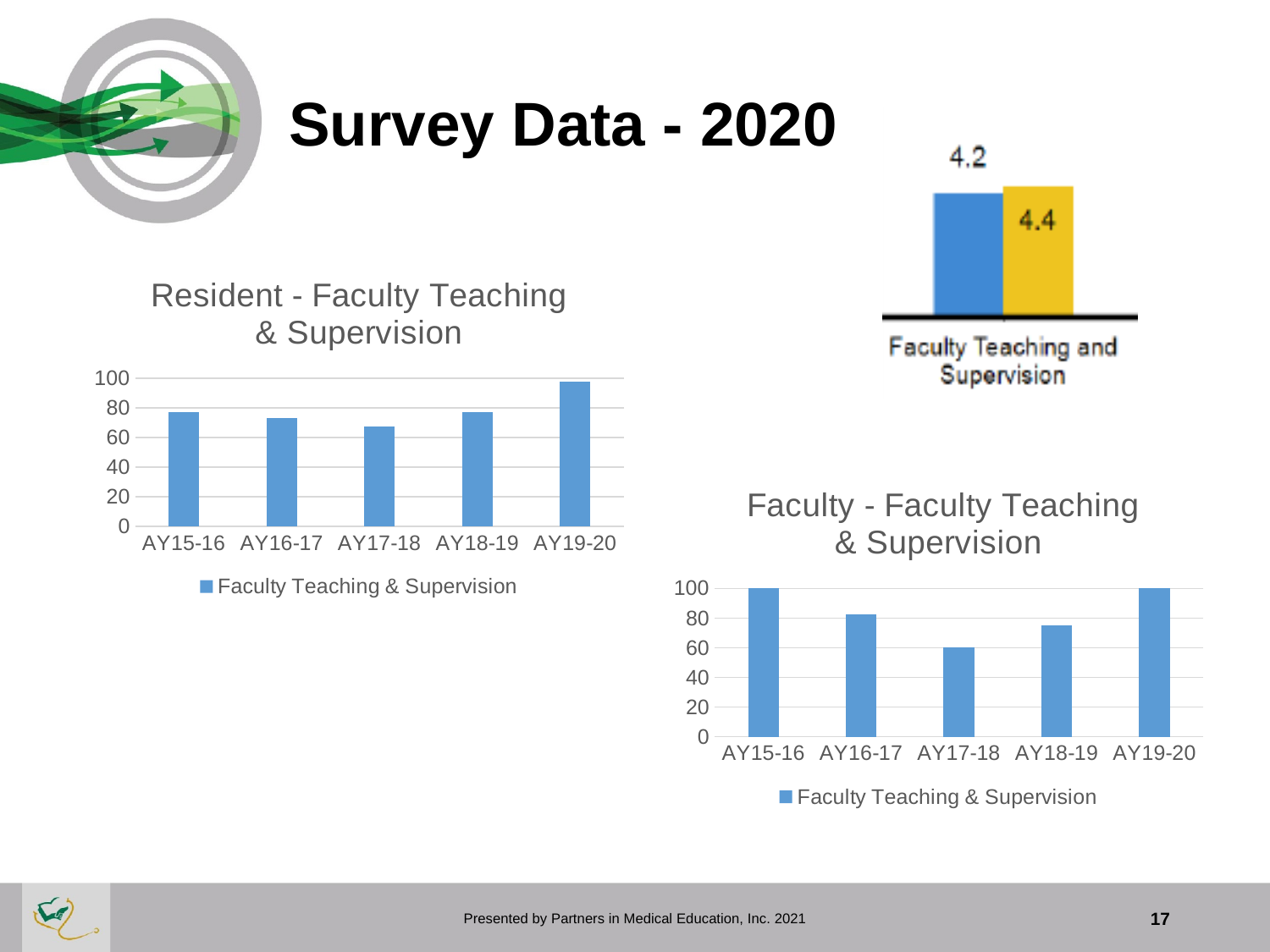
In the small chart at the top right labelled 'Faculty Teaching and Supervision', which bar is larger, the blue one or the yellow one? the yellow one What type of chart is the 'Faculty - Faculty Teaching & Supervision' chart? bar chart In the small chart at the top right labelled 'Faculty Teaching and Supervision', what value is shown for the yellow bar? 4.4 In the small chart at the top right labelled 'Faculty Teaching and Supervision', what value is shown for the blue bar? 4.2 In the 'Resident - Faculty Teaching & Supervision' chart, which academic year has the lowest value? AY17-18 In the 'Resident - Faculty Teaching & Supervision' chart, which academic year has the highest value? AY19-20 In the 'Resident - Faculty Teaching & Supervision' chart, is the value for AY19-20 greater or less than 80? greater In the small chart at the top right labelled 'Faculty Teaching and Supervision', what is the difference between the yellow bar's value and the blue bar's value? 0.2 In the 'Faculty - Faculty Teaching & Supervision' chart, which is larger, the value for AY16-17 or the value for AY17-18? AY16-17 In the 'Faculty - Faculty Teaching & Supervision' chart, is the value for AY18-19 greater or less than 60? greater In the 'Faculty - Faculty Teaching & Supervision' chart, which academic year has the lowest value? AY17-18 In the 'Resident - Faculty Teaching & Supervision' chart, how many academic years are shown on the x axis? 5